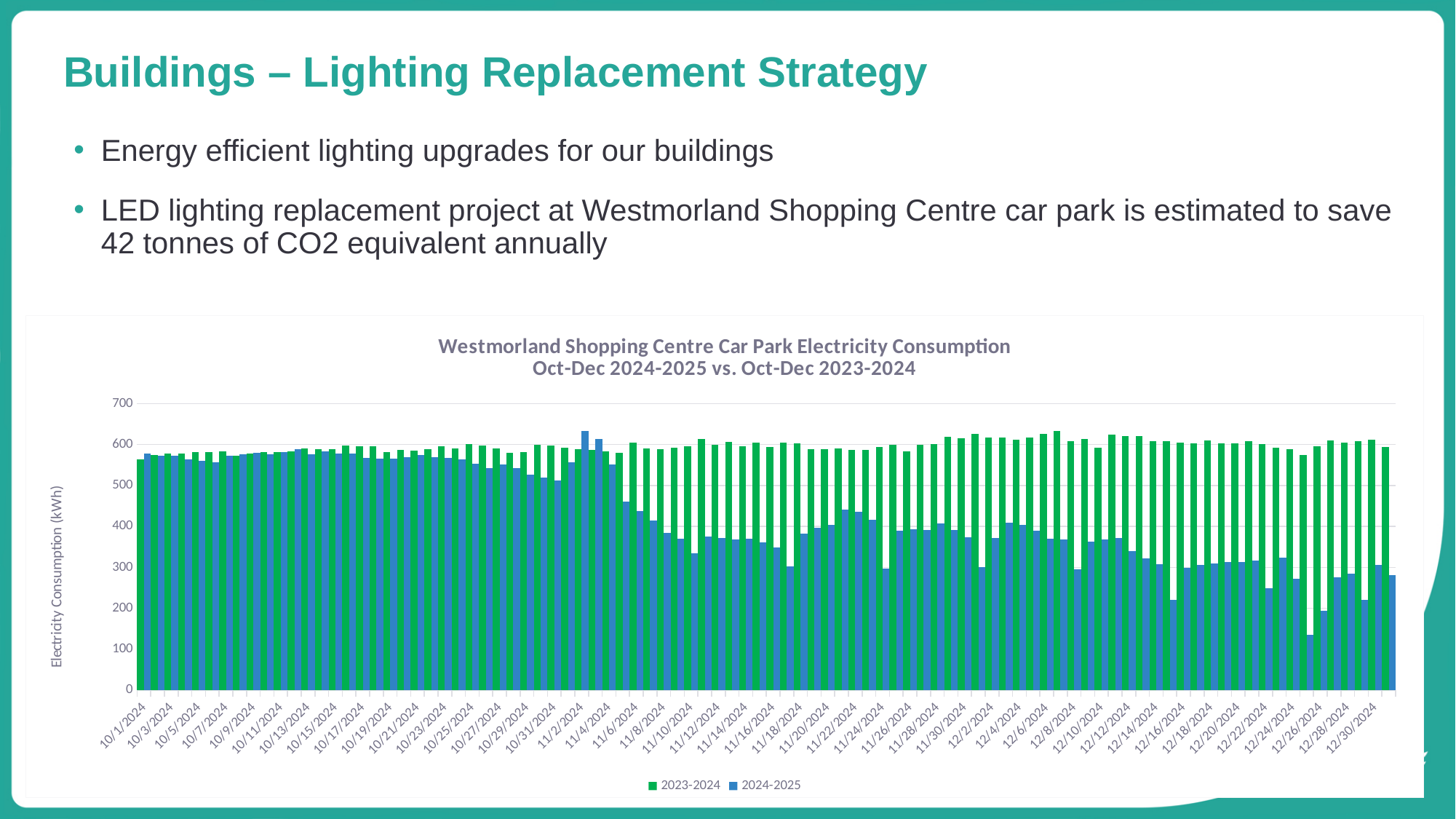
Is the 2024-2025 value for 11/10/2024 greater or less than 400? less On 12/30/2024, which series has the larger value, 2023-2024 or 2024-2025? 2023-2024 Does the 2024-2025 series generally rise or fall from October to December along the x axis? Fall How many series does the chart's legend list? 2 Is the 2024-2025 value for 10/1/2024 greater or less than 500? greater What is the title of the chart? Westmorland Shopping Centre Car Park Electricity Consumption Oct-Dec 2024-2025 vs. Oct-Dec 2023-2024 Is the 2024-2025 value for 11/2/2024 greater or less than 600? greater What kind of chart is shown on the slide? Bar chart What is the label on the chart's vertical axis? Electricity Consumption (kWh) On 11/16/2024, which series has the larger value, 2023-2024 or 2024-2025? 2023-2024